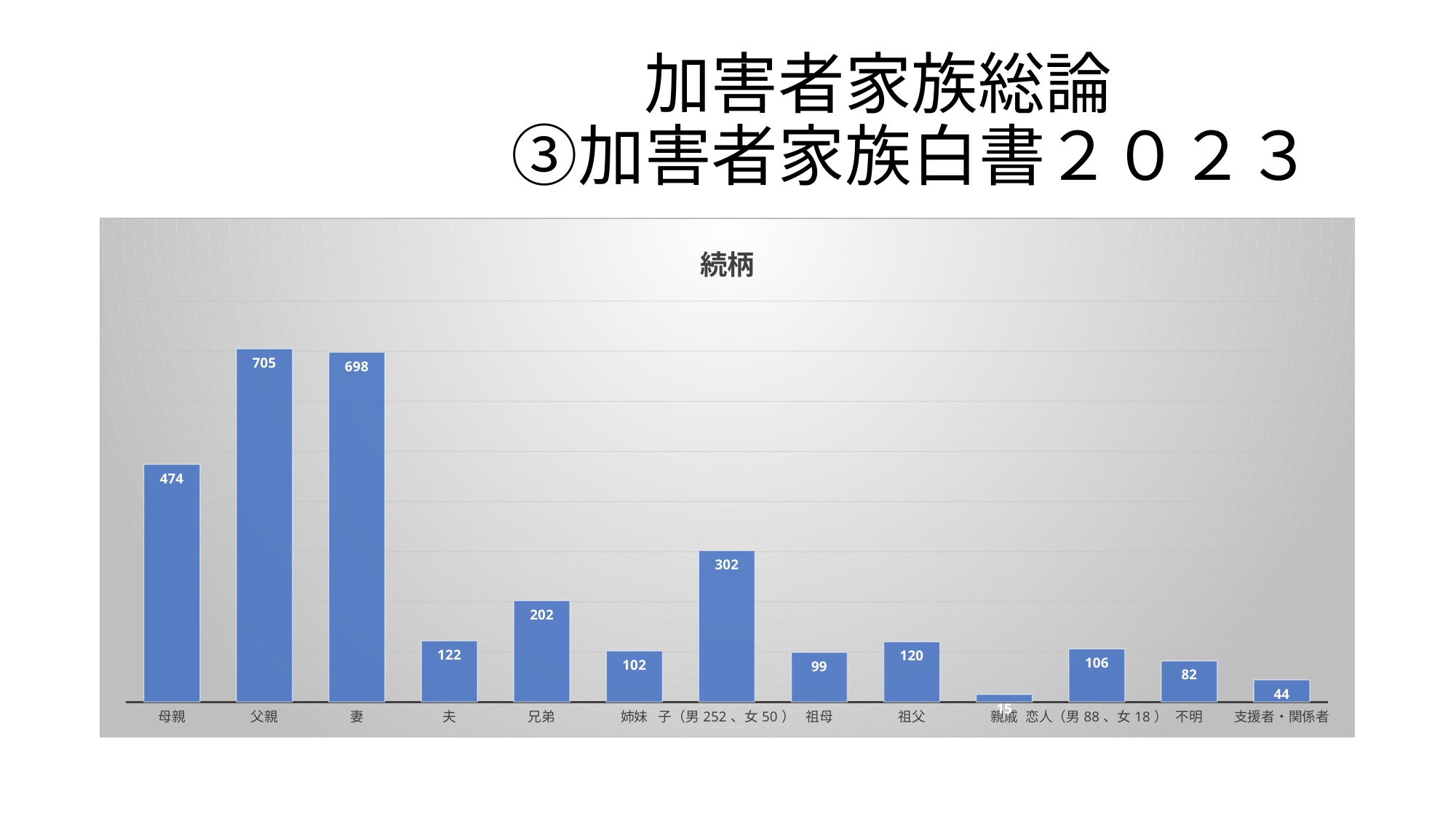
How many categories are shown on the x axis? 13 What is the value for 妻? 698 What is the value for 子（男252、女50）? 302 What is the value for 支援者・関係者? 44 Which category has the highest value? 父親 Which category has the lowest value? 親戚 Which is larger, the value for 兄弟 or the value for 夫? 兄弟 What is the value for 母親? 474 What is the difference between the values for 父親 and 妻? 7 What type of chart is shown on the slide? bar chart What is the title of the chart? 続柄 What is the difference between the values for 祖父 and 祖母? 21